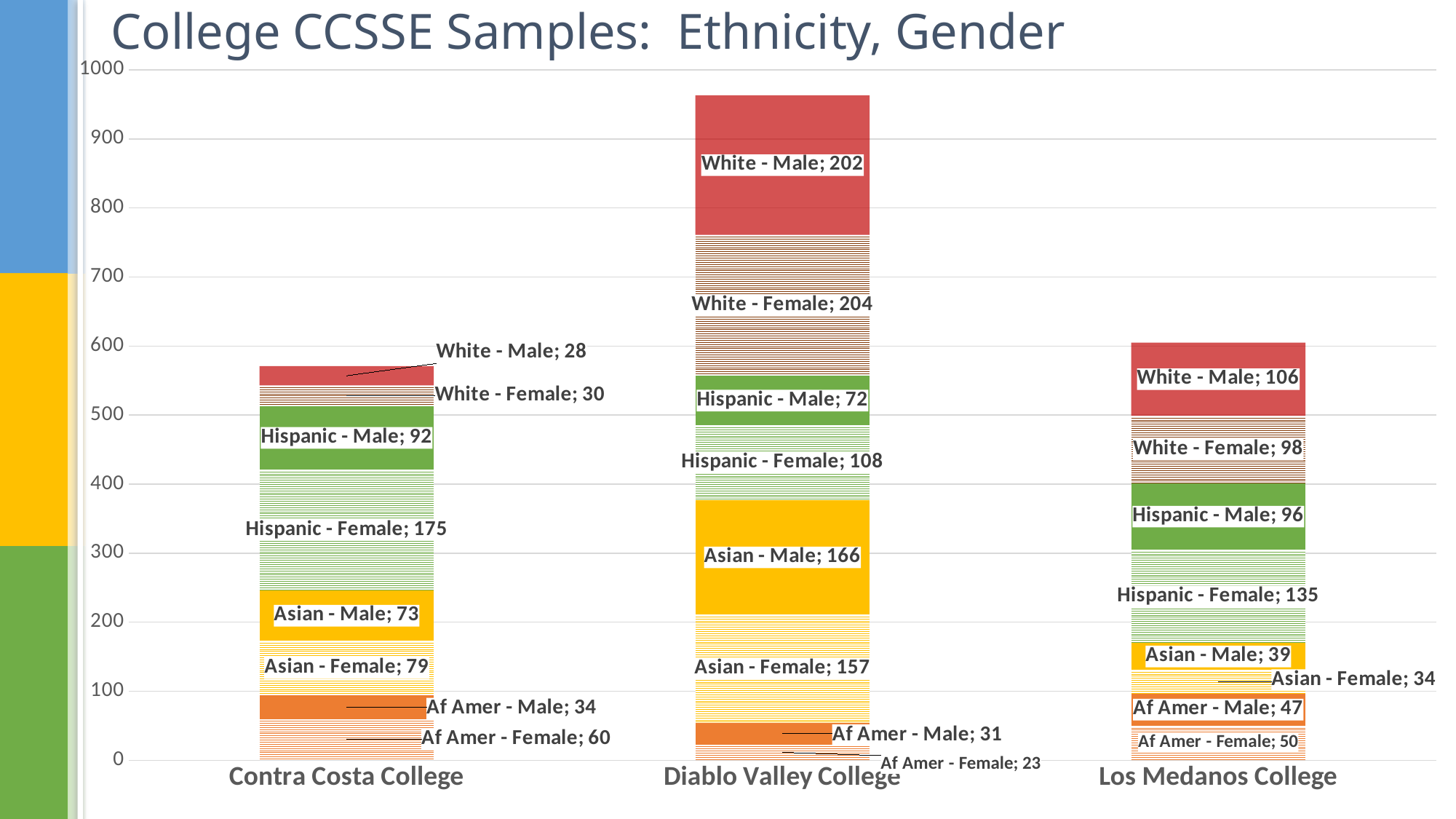
How many colleges are shown on the x axis? 3 What is the total of the Los Medanos College stacked bar? 605 What is the value for Af Amer - Female at Diablo Valley College? 23 What is the value for Asian - Female at Los Medanos College? 34 Which college has the tallest stacked bar? Diablo Valley College What is the difference between White - Female and White - Male at Los Medanos College? 8 What is the value for White - Male at Diablo Valley College? 202 What kind of chart is this? stacked bar chart Is the total of the Diablo Valley College bar greater or less than 900? greater Which is larger at Contra Costa College, Asian - Female or Asian - Male? Asian - Female What is the value for Hispanic - Female at Contra Costa College? 175 Which college has the shortest stacked bar? Contra Costa College